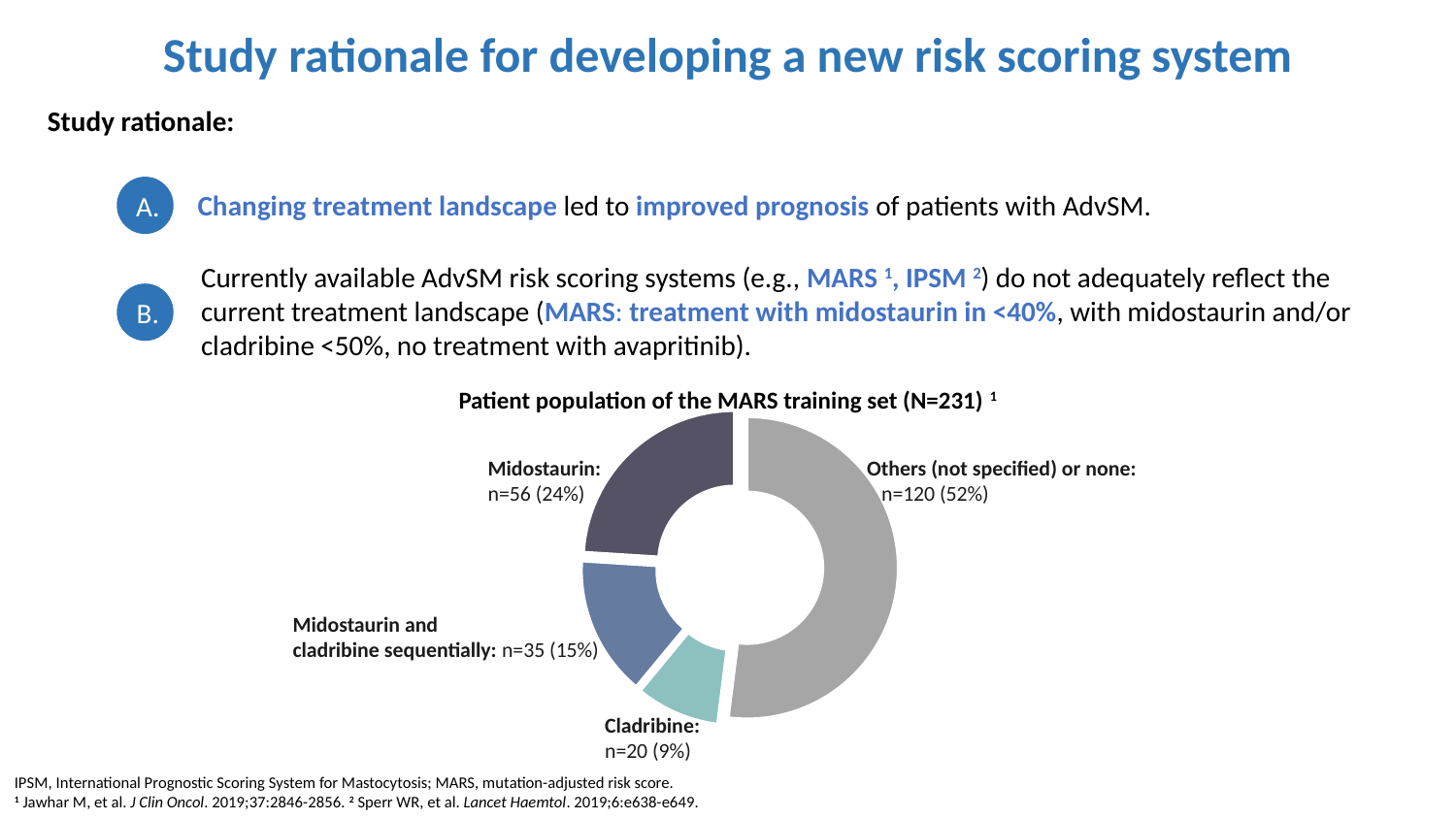
Which is larger, the Midostaurin slice or the Cladribine slice? Midostaurin Which category has the largest slice? Others (not specified) or none What kind of chart is shown on the slide? Pie chart (donut) What share of the pie does the Others (not specified) or none slice represent? 52% How many categories does the pie chart show? 4 What is the difference in patient numbers between Others (not specified) or none and Midostaurin? 64 Which category has the smallest slice? Cladribine What is the value for Midostaurin and cladribine sequentially? n=35 (15%) What is the title of the chart? Patient population of the MARS training set (N=231) What is the combined number of patients in the Midostaurin and Cladribine categories? 76 What share of the pie does the Cladribine slice represent? 9% How many patients are in the Midostaurin category? n=56 (24%)